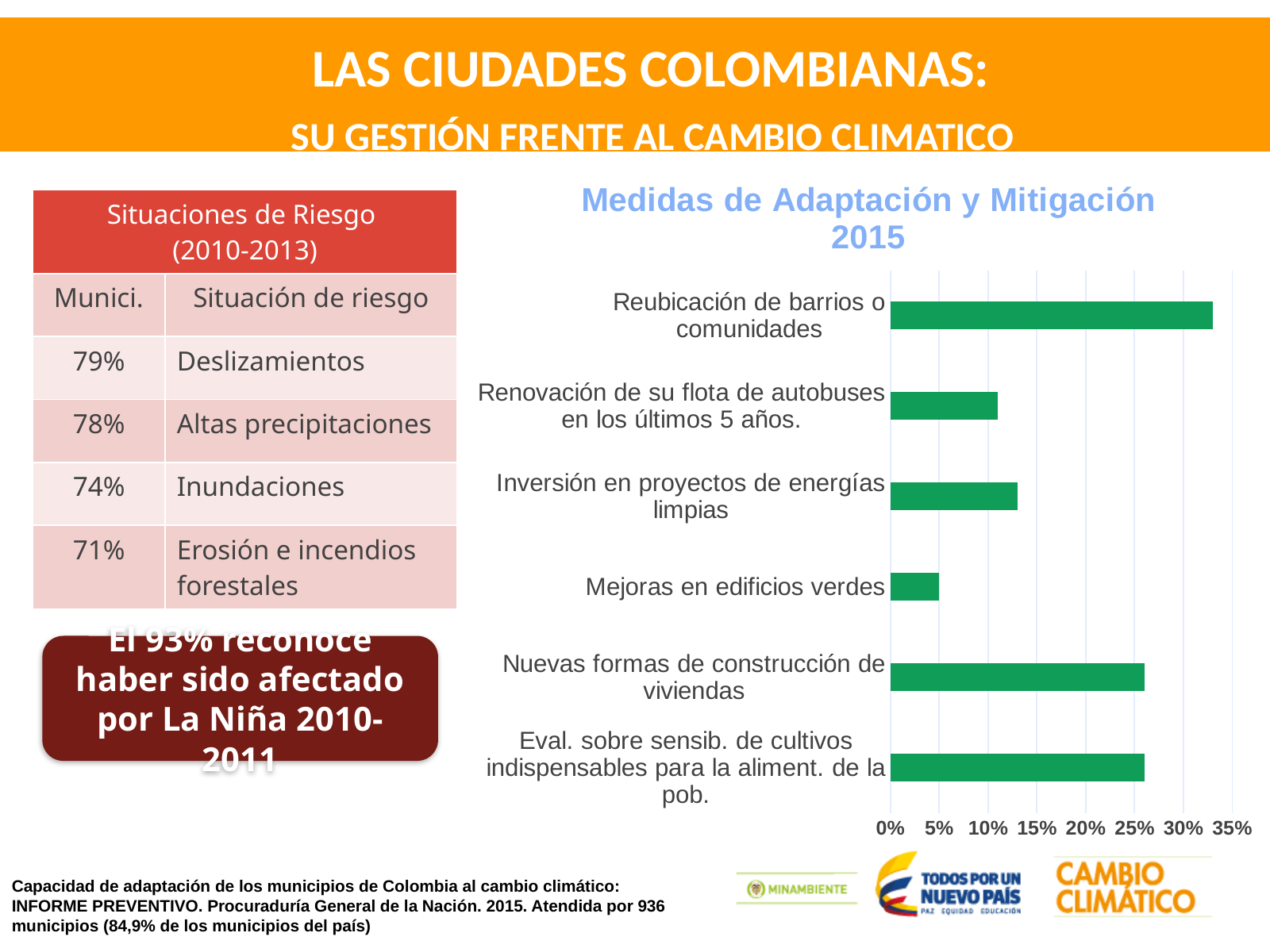
What kind of chart is shown under the title "Medidas de Adaptación y Mitigación 2015"? bar chart In the "Medidas de Adaptación y Mitigación 2015" chart, which is larger: the value for "Reubicación de barrios o comunidades" or the value for "Nuevas formas de construcción de viviendas"? Reubicación de barrios o comunidades Which measure has the highest value in the "Medidas de Adaptación y Mitigación 2015" chart? Reubicación de barrios o comunidades In the "Medidas de Adaptación y Mitigación 2015" chart, which is larger: the value for "Mejoras en edificios verdes" or the value for "Inversión en proyectos de energías limpias"? Inversión en proyectos de energías limpias Which measure has the lowest value in the "Medidas de Adaptación y Mitigación 2015" chart? Mejoras en edificios verdes In the "Medidas de Adaptación y Mitigación 2015" chart, is the value for "Mejoras en edificios verdes" greater or less than 10%? less What colour are the bars in the "Medidas de Adaptación y Mitigación 2015" chart? green In the "Medidas de Adaptación y Mitigación 2015" chart, is the value for "Nuevas formas de construcción de viviendas" greater or less than 20%? greater In the "Medidas de Adaptación y Mitigación 2015" chart, is the value for "Inversión en proyectos de energías limpias" greater or less than 10%? greater How many measures (categories) are plotted in the "Medidas de Adaptación y Mitigación 2015" chart? 6